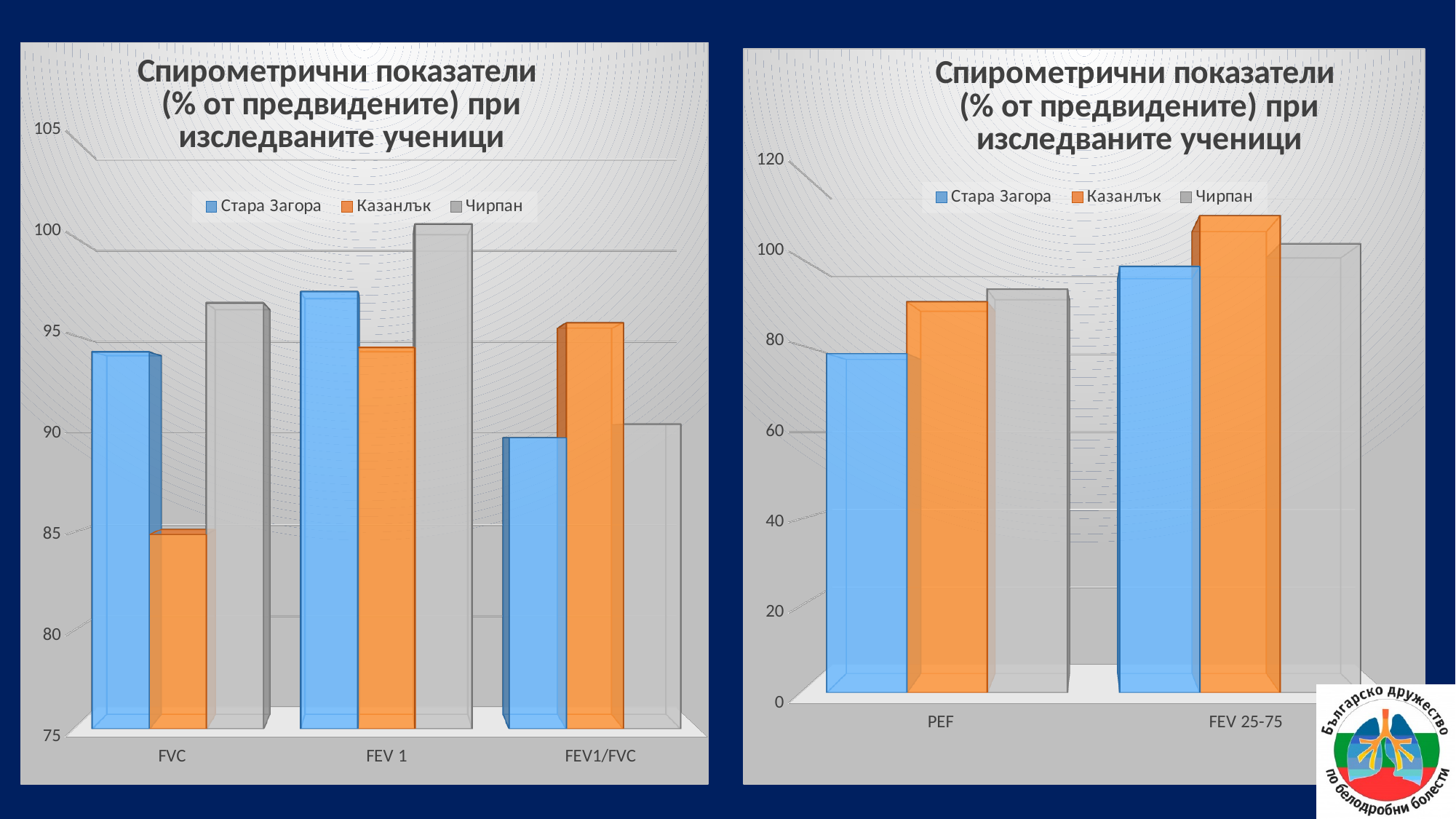
How many categories are shown on the x axis of the right chart? 2 In the left chart, which series has the highest value for FEV 1? Чирпан In the left chart, which series has the lowest value for FVC? Казанлък How many categories are shown on the x axis of the left chart? 3 What kind of chart is the left chart? bar chart In the right chart, which series has the lowest value for PEF? Стара Загора In the right chart, which series has the highest value for FEV 25-75? Казанлък How many series does the legend of the right chart list? 3 In the left chart, is the value of Казанлък for FVC greater or less than 90? less In the left chart, which is larger for FEV1/FVC: Стара Загора or Казанлък? Казанлък